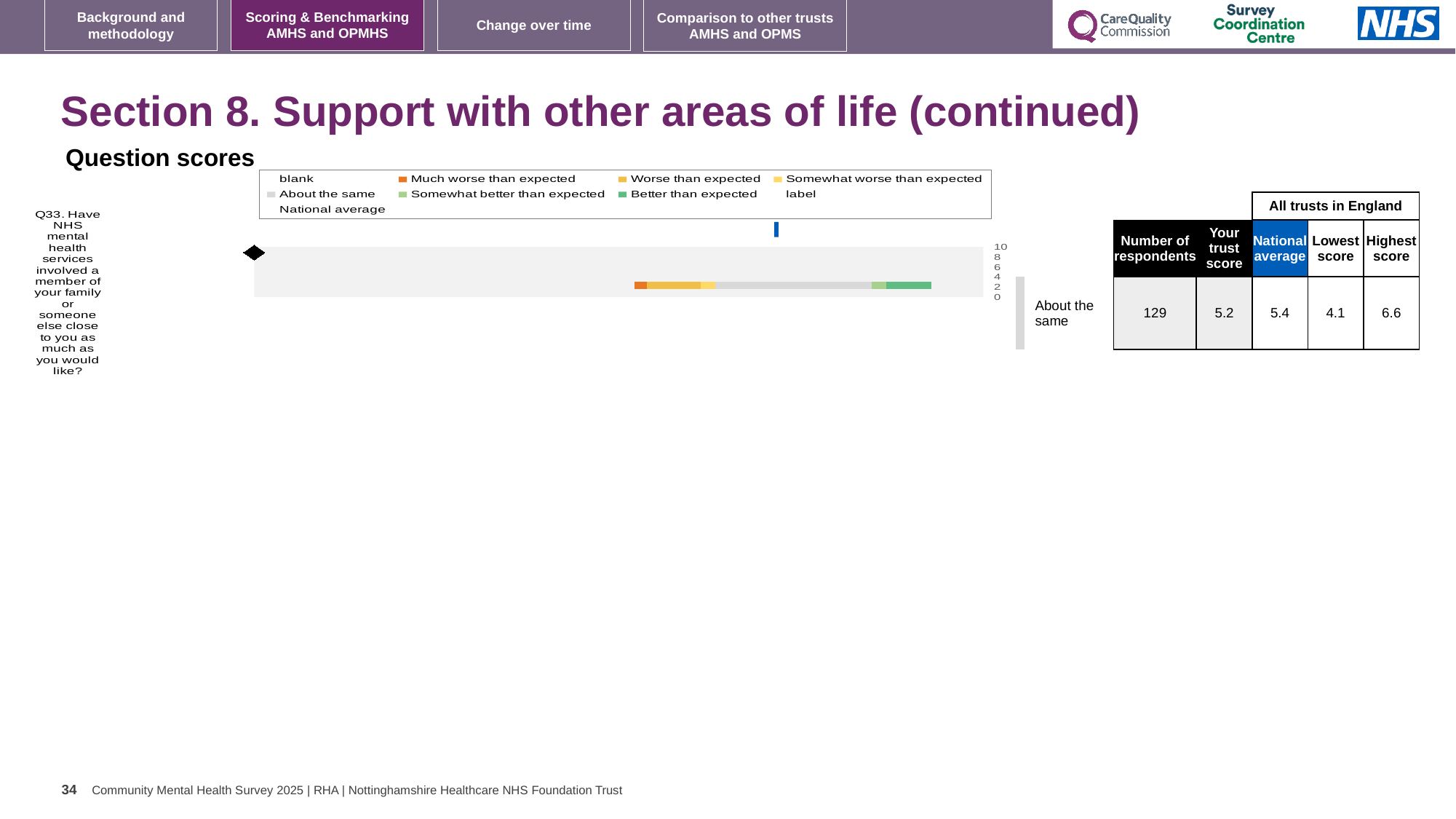
In the table beside the Question scores chart, what is the lowest score among all trusts in England for Q33? 4.1 In the Question scores chart legend, which colour represents 'Much worse than expected'? orange In the table beside the Question scores chart, what is the highest score among all trusts in England for Q33? 6.6 What kind of chart is shown under 'Question scores'? bar chart What benchmark category label is shown to the right of the bar for Q33 in the Question scores chart? About the same In the table beside the Question scores chart, what is the number of respondents for Q33? 129 In the table beside the Question scores chart, which is larger for Q33: your trust score or the national average? national average How many entries does the legend of the Question scores chart list? 9 How many questions (categories) are plotted in the Question scores chart? 1 Which question is plotted in the Question scores chart? Q33. Have NHS mental health services involved a member of your family or someone else close to you as much as you would like? In the table beside the Question scores chart, what is 'Your trust score' for Q33? 5.2 In the table beside the Question scores chart, what is the national average for Q33? 5.4